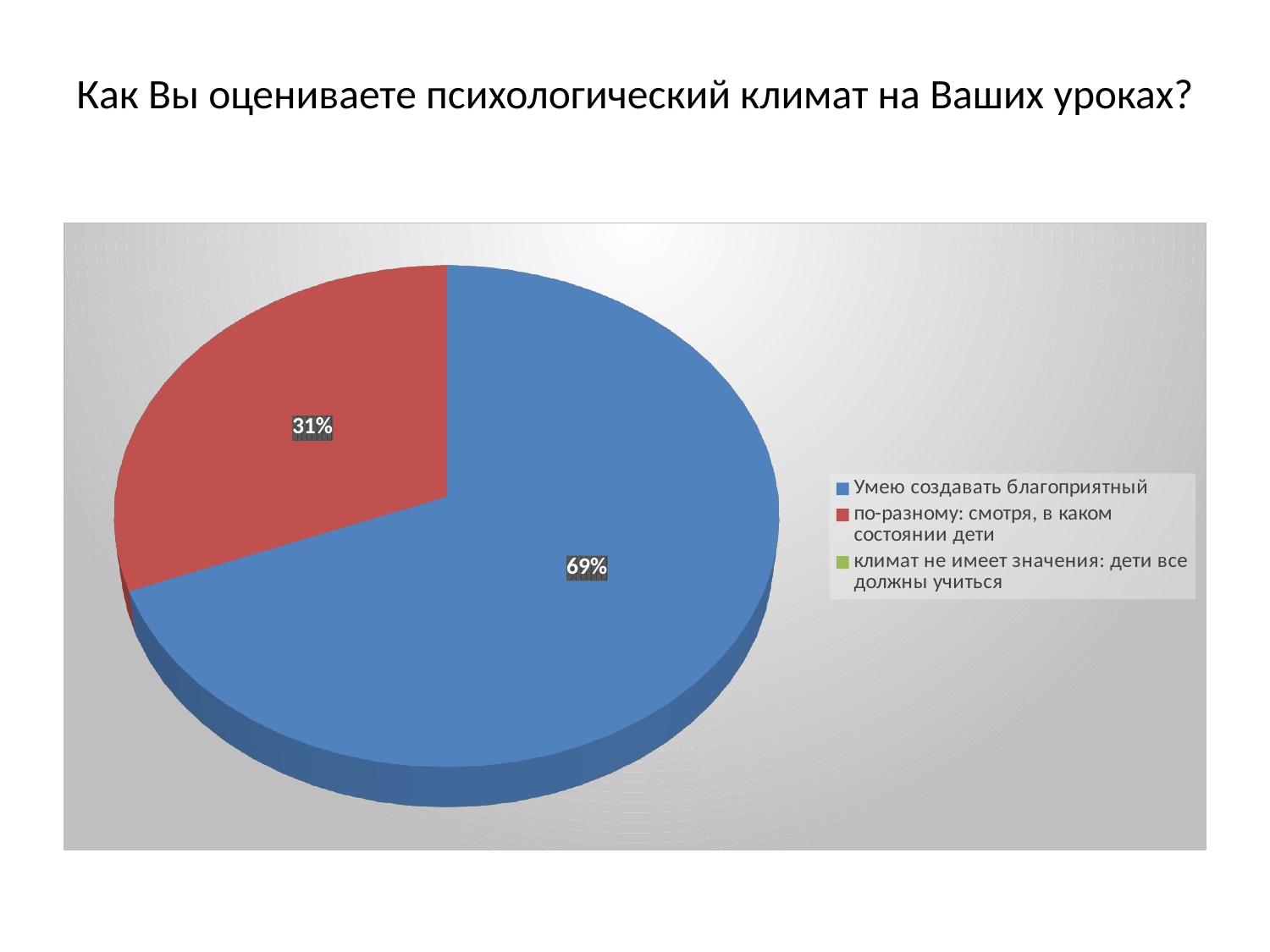
What share of the pie does the slice "Умею создавать благоприятный" take? 69% Which legend entry has no visible slice in the pie? климат не имеет значения: дети все должны учиться What is the title of the slide above the chart? Как Вы оцениваете психологический климат на Ваших уроках? What is the difference in percentage points between the "Умею создавать благоприятный" slice and the "по-разному: смотря, в каком состоянии дети" slice? 38 percentage points How many slices with a printed percentage are visible in the pie? 2 Which category has the largest slice of the pie? Умею создавать благоприятный What colour is the slice labelled 69%? blue Which of the two visible slices is smaller, "Умею создавать благоприятный" or "по-разному: смотря, в каком состоянии дети"? по-разному: смотря, в каком состоянии дети What share of the pie does the slice "по-разному: смотря, в каком состоянии дети" take? 31% How many entries does the legend list? 3 What kind of chart is shown on the slide? pie chart